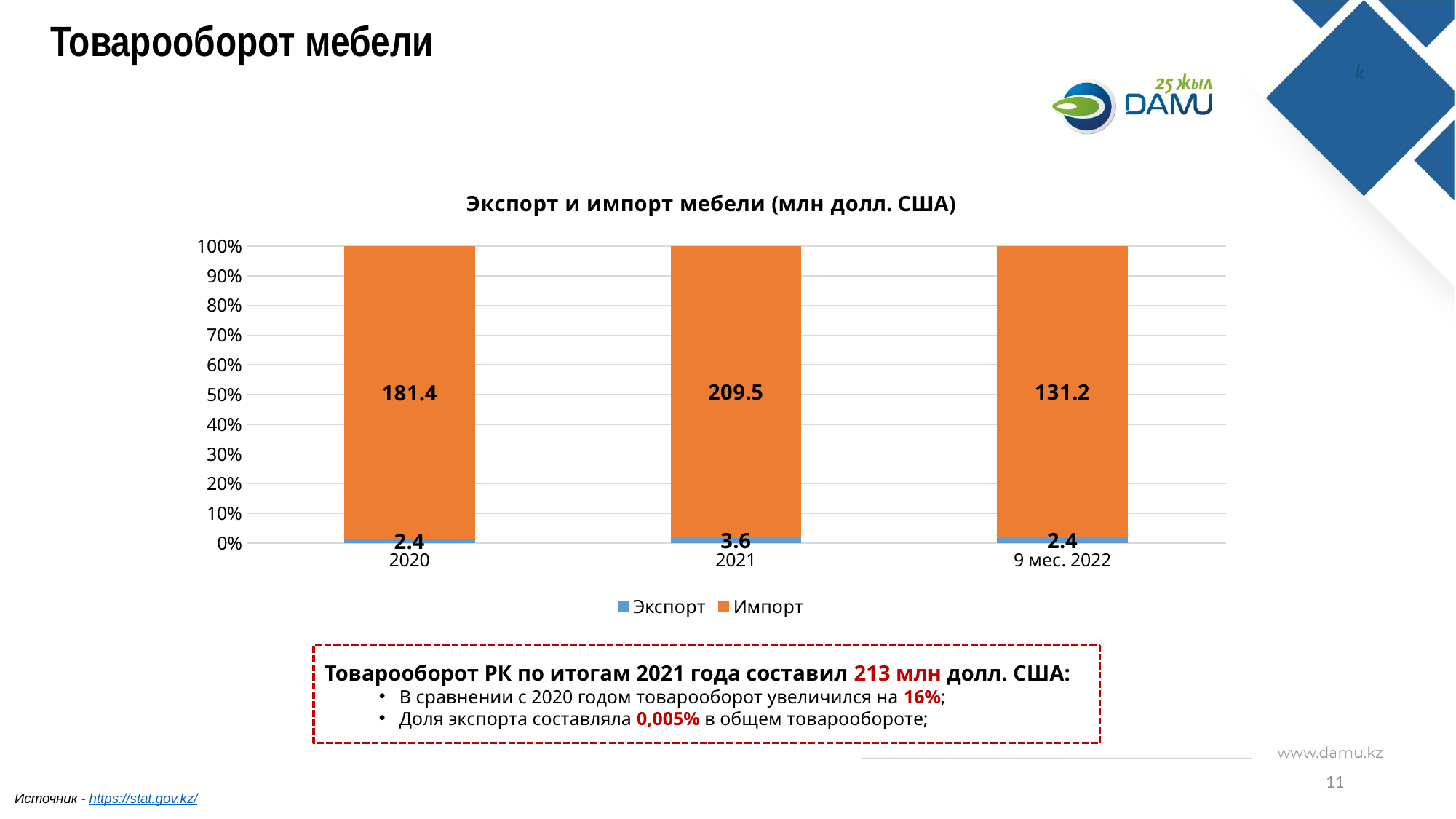
What is the difference between the Экспорт values for 2021 and 2020? 1.2 Which category has the lowest Импорт value? 9 мес. 2022 What is the total of Экспорт and Импорт for 2021? 213.1 How many categories are shown on the x axis? 3 What is the Импорт value for 2021? 209.5 Which is larger, the Импорт value for 2020 or for 9 мес. 2022? 2020 What is the Импорт value for 9 мес. 2022? 131.2 What kind of chart is shown on the slide? Stacked bar chart What is the difference between the Импорт values for 2021 and 2020? 28.1 What is the Экспорт value for 2020? 2.4 How many series does the legend list? 2 Which category has the highest Импорт value? 2021